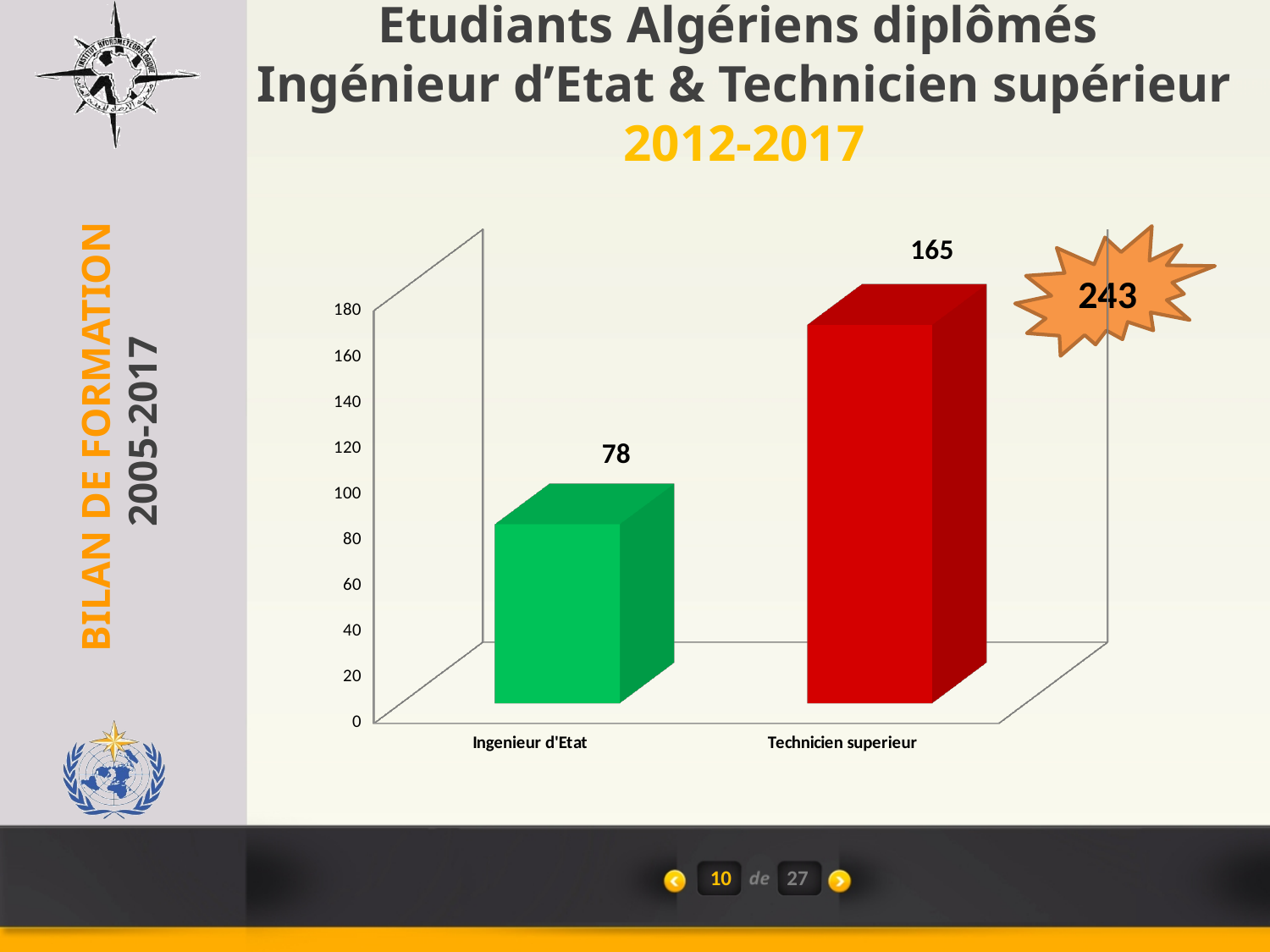
How many categories are shown on the x axis? 2 Is the value for Technicien superieur greater or less than 140? greater What number is shown in the starburst shape next to the chart? 243 Is the value for Ingenieur d'Etat greater or less than 100? less What is the value for Technicien superieur? 165 Which is larger, the value for Ingenieur d'Etat or the value for Technicien superieur? Technicien superieur What kind of chart is shown on the slide? bar chart What is the difference between the values for Technicien superieur and Ingenieur d'Etat? 87 What is the value for Ingenieur d'Etat? 78 Which category has the lowest value? Ingenieur d'Etat What is the total of the two values shown in the chart? 243 Which category has the highest value? Technicien superieur